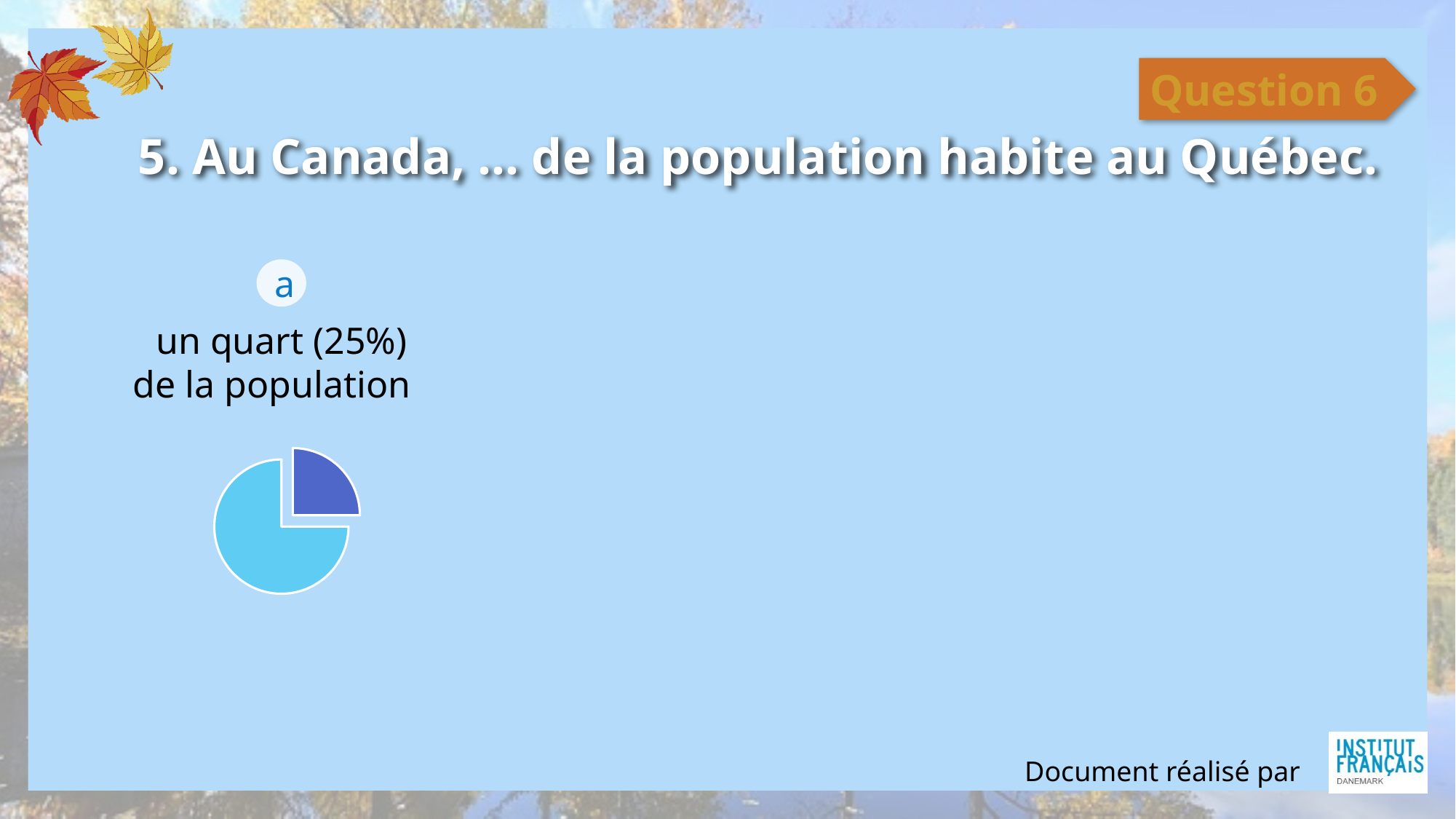
What text label accompanies the pie chart under option a? un quart (25%) de la population What colour is the slice that is pulled out from the rest of the pie? dark blue How many slices does the pie chart have? 2 Is the share of the light blue slice greater or less than 50%? greater What share of the pie does the separated (exploded) dark blue slice represent, according to the label above the chart? 25% What kind of chart is shown on the slide? pie chart Is the share of the dark blue slice greater or less than 50%? less Which slice of the pie chart is larger, the dark blue slice or the light blue slice? the light blue slice